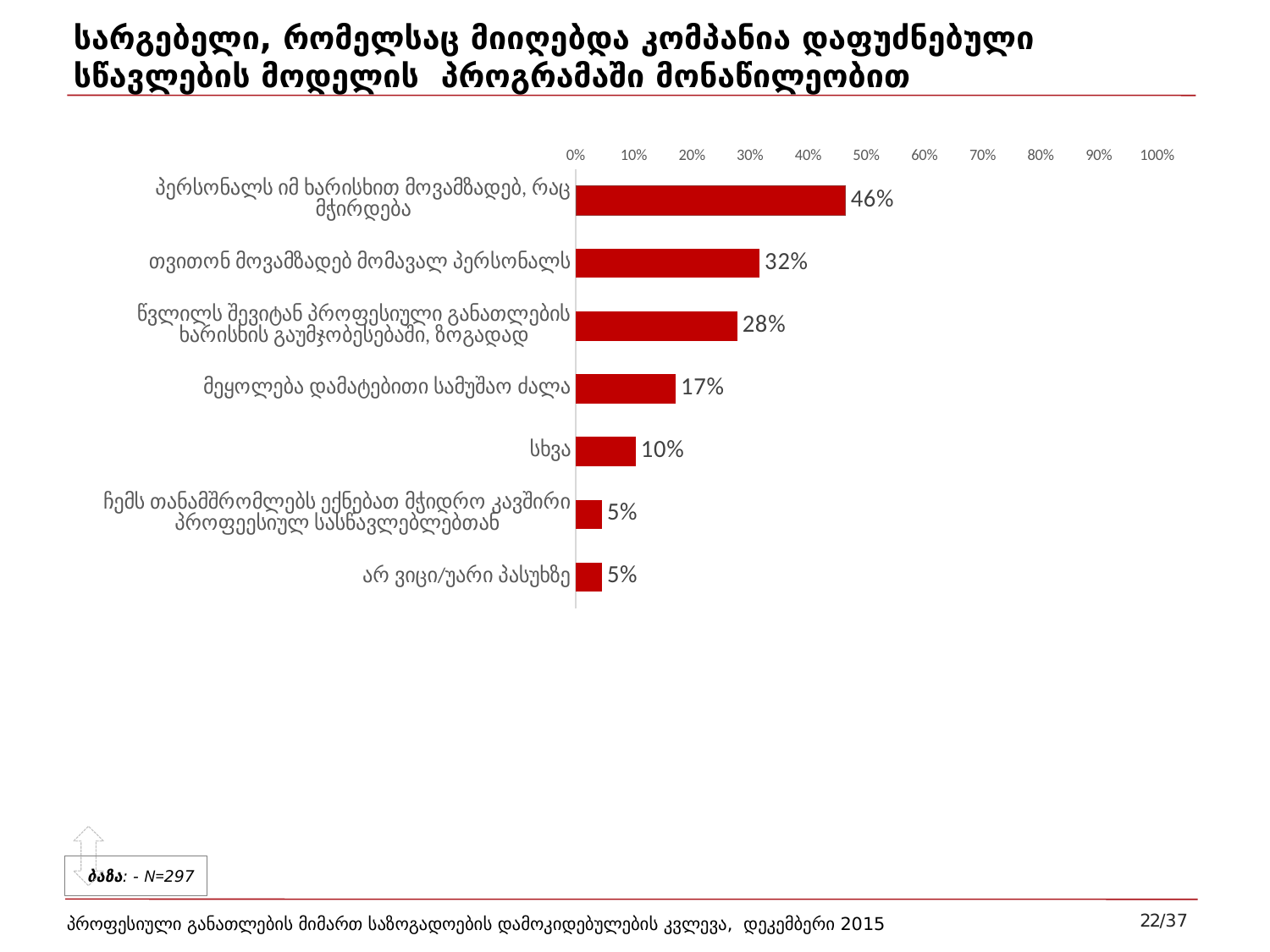
How many categories are shown on the chart? 7 What is the lowest value shown on the chart? 5% Which category has the highest value? პერსონალს იმ ხარისხით მოვამზადებ, რაც მჭირდება Which is larger: the value for "წვლილს შევიტან პროფესიული განათლების ხარისხის გაუმჯობესებაში, ზოგადად" or the value for "მეყოლება დამატებითი სამუშაო ძალა"? წვლილს შევიტან პროფესიული განათლების ხარისხის გაუმჯობესებაში, ზოგადად What is the value for "მეყოლება დამატებითი სამუშაო ძალა"? 17% What is the value for "არ ვიცი/უარი პასუხზე"? 5% What is the value for "სხვა"? 10% What is the value for "პერსონალს იმ ხარისხით მოვამზადებ, რაც მჭირდება"? 46% What kind of chart is shown on the slide? bar chart What is the difference between the values for "პერსონალს იმ ხარისხით მოვამზადებ, რაც მჭირდება" and "თვითონ მოვამზადებ მომავალ პერსონალს"? 14% Is the value for "თვითონ მოვამზადებ მომავალ პერსონალს" greater or less than 40%? less What is the value for "თვითონ მოვამზადებ მომავალ პერსონალს"? 32%